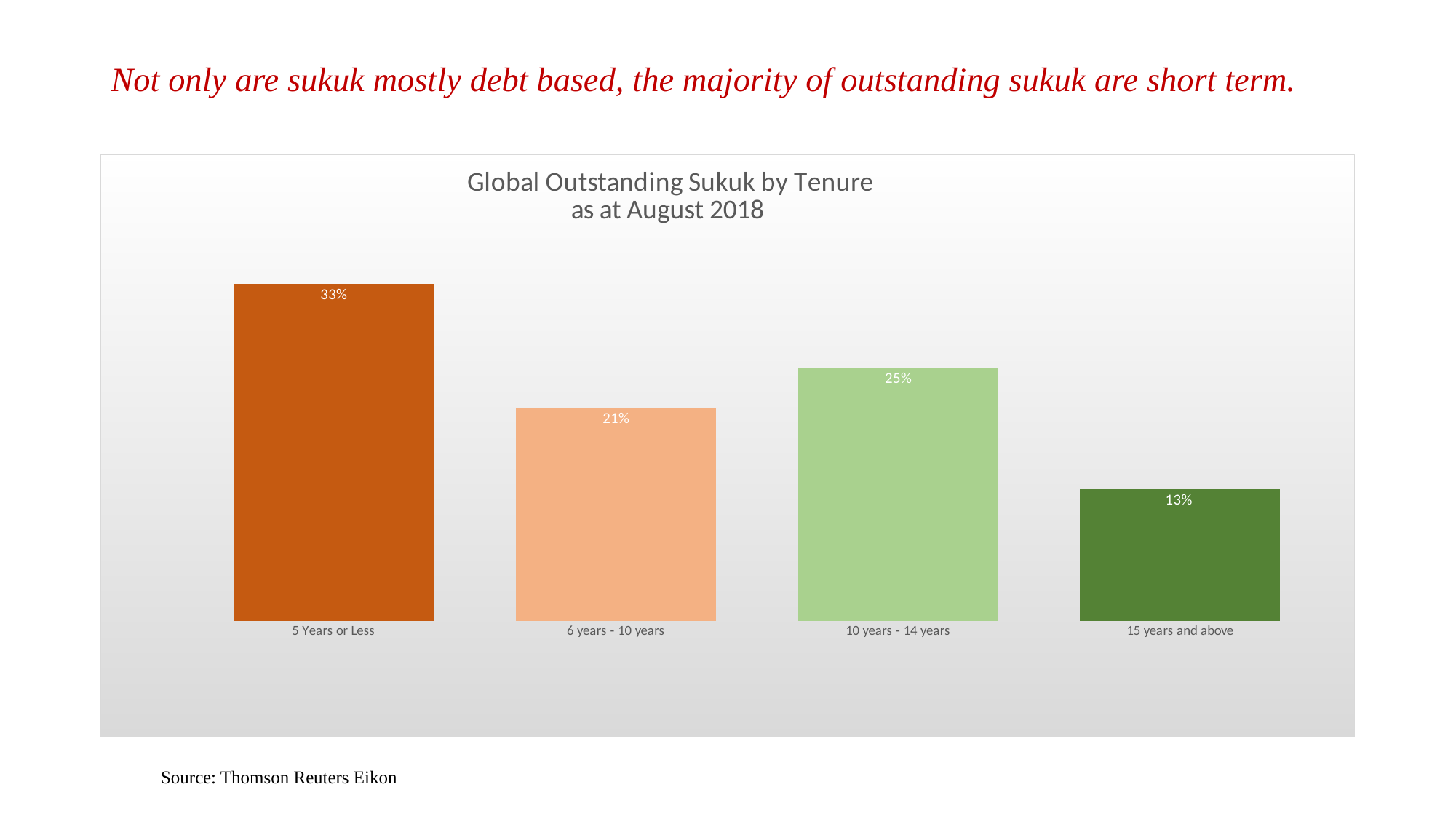
What is the value for 10 years - 14 years? 25% What is the title of the chart? Global Outstanding Sukuk by Tenure as at August 2018 Which is larger, the value for 6 years - 10 years or the value for 10 years - 14 years? 10 years - 14 years What kind of chart is shown on the slide? Bar chart What is the difference between the values for 5 Years or Less and 15 years and above? 20% What is the value for 5 Years or Less? 33% What is the difference between the values for 10 years - 14 years and 6 years - 10 years? 4% How many tenure categories are shown in the chart? 4 What is the value for 6 years - 10 years? 21% What is the value for 15 years and above? 13% Which tenure category has the highest share of outstanding sukuk? 5 Years or Less Which tenure category has the lowest share of outstanding sukuk? 15 years and above